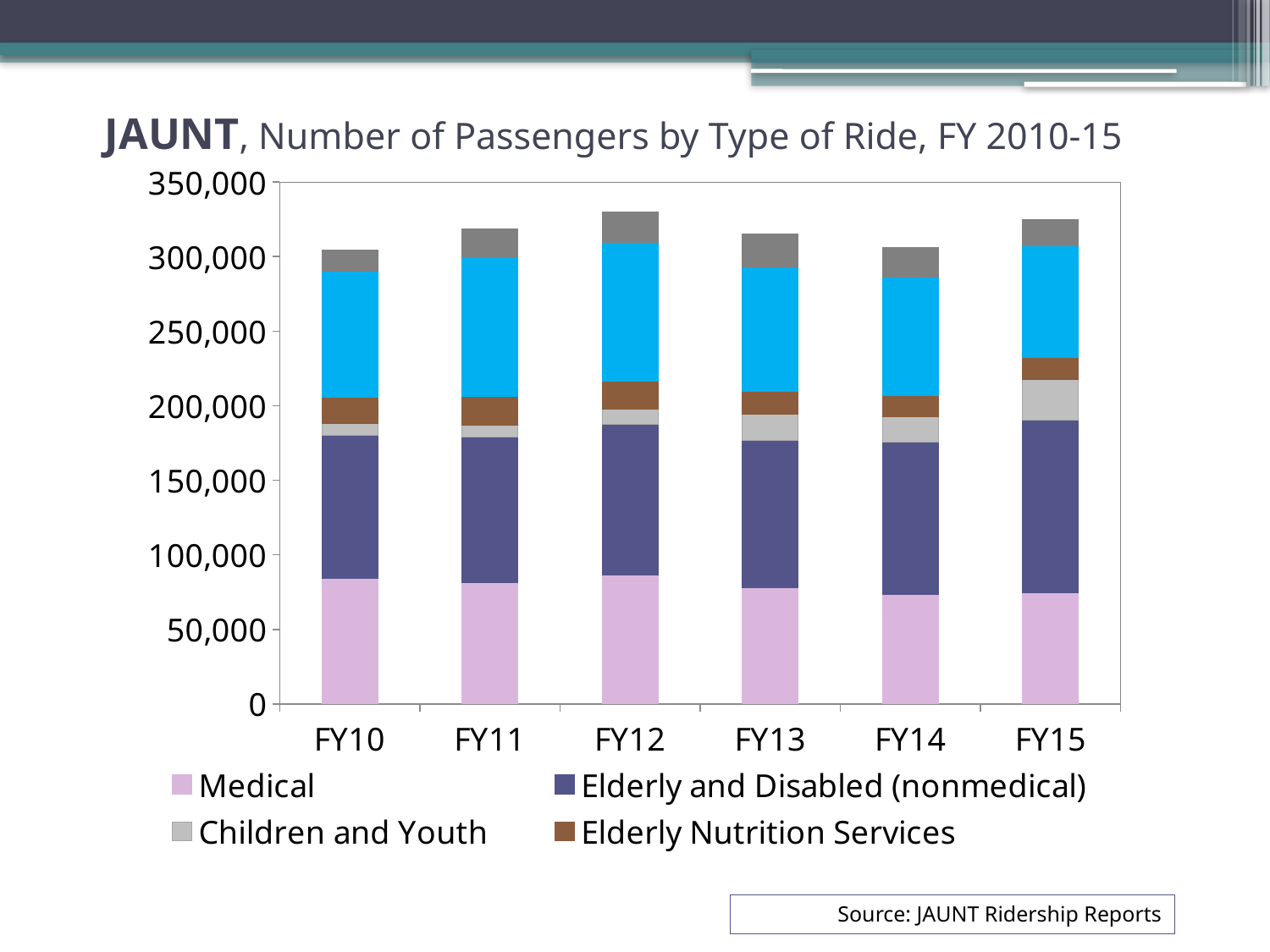
Is the Medical value for FY15 greater or less than 50,000? greater Is the Medical value for FY10 greater or less than 100,000? less Which is larger, the total bar for FY12 or the total bar for FY13? FY12 Which legend entry is shown in brown? Elderly Nutrition Services How many fiscal years are shown on the x axis of the chart? 6 Which is larger, the Medical value for FY10 or the Medical value for FY14? FY10 How many series does the chart's legend list? 4 Which fiscal year has the tallest total bar? FY12 What kind of chart is shown on the slide? Stacked bar chart Is the total number of passengers in FY12 greater or less than 300,000? greater What is the title of the chart? JAUNT, Number of Passengers by Type of Ride, FY 2010-15